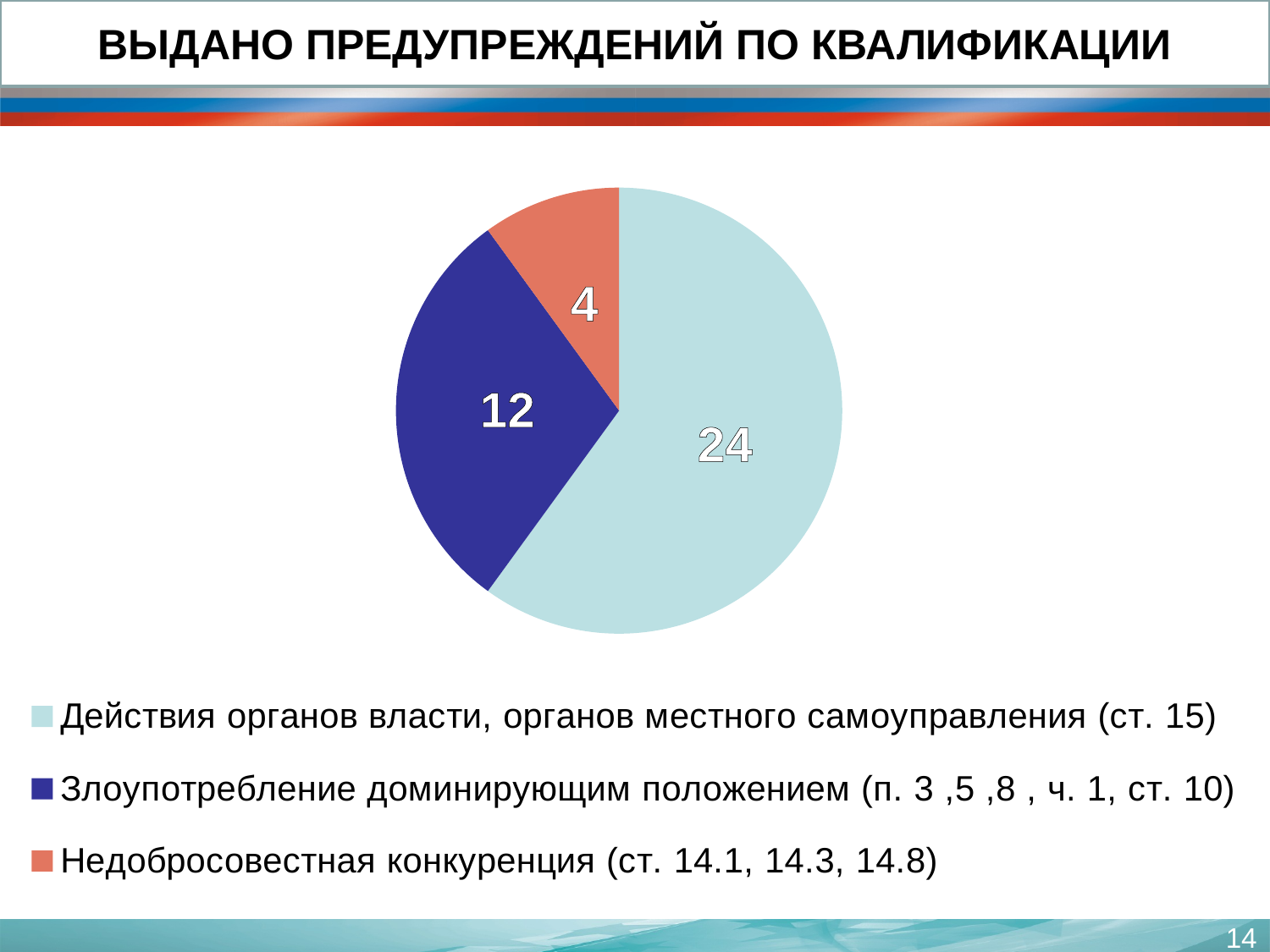
How many slices does the pie chart have? 3 What kind of chart is shown on the slide? Pie chart What is the value for "Действия органов власти, органов местного самоуправления (ст. 15)"? 24 Which is larger: the value for "Злоупотребление доминирующим положением (п. 3 ,5 ,8 , ч. 1, ст. 10)" or for "Недобросовестная конкуренция (ст. 14.1, 14.3, 14.8)"? Злоупотребление доминирующим положением (п. 3 ,5 ,8 , ч. 1, ст. 10) What is the value for "Злоупотребление доминирующим положением (п. 3 ,5 ,8 , ч. 1, ст. 10)"? 12 Which category has the largest slice of the pie? Действия органов власти, органов местного самоуправления (ст. 15) What share of the pie does "Действия органов власти, органов местного самоуправления (ст. 15)" represent? 60% What is the title of the slide? ВЫДАНО ПРЕДУПРЕЖДЕНИЙ ПО КВАЛИФИКАЦИИ What is the difference between the values for "Действия органов власти, органов местного самоуправления (ст. 15)" and "Злоупотребление доминирующим положением (п. 3 ,5 ,8 , ч. 1, ст. 10)"? 12 Which category has the smallest slice of the pie? Недобросовестная конкуренция (ст. 14.1, 14.3, 14.8) What is the value for "Недобросовестная конкуренция (ст. 14.1, 14.3, 14.8)"? 4 What is the total of all slices in the pie chart? 40